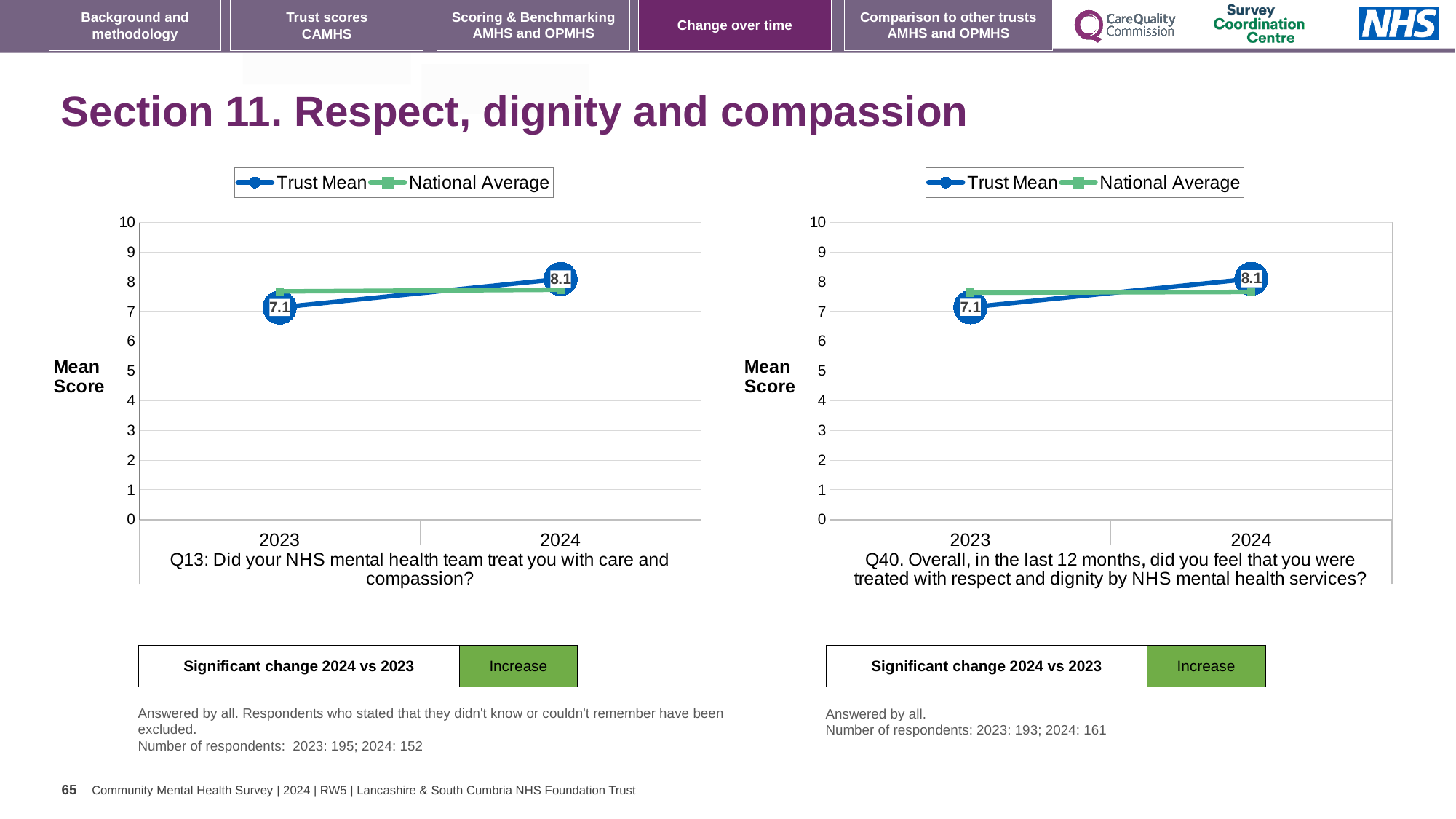
What does the 'Significant change 2024 vs 2023' box below the right chart (Q40) say? Increase In the left chart (Q13), by how much did the Trust Mean change from 2023 to 2024? 1.0 What type of chart is the left chart (Q13)? line chart In the left chart (Q13), what is the Trust Mean for 2023? 7.1 How many years are shown on the x axis of the left chart (Q13)? 2 In the right chart (Q40), does the Trust Mean rise or fall from 2023 to 2024? rise In the left chart (Q13), what is the Trust Mean for 2024? 8.1 How many series does the legend of the right chart (Q40) list? 2 In the right chart (Q40), what is the Trust Mean for 2023? 7.1 In the right chart (Q40), what is the Trust Mean for 2024? 8.1 In the left chart (Q13), for 2023, which is larger: the Trust Mean or the National Average? National Average In the right chart (Q40), is the National Average for 2023 greater or less than 7? greater